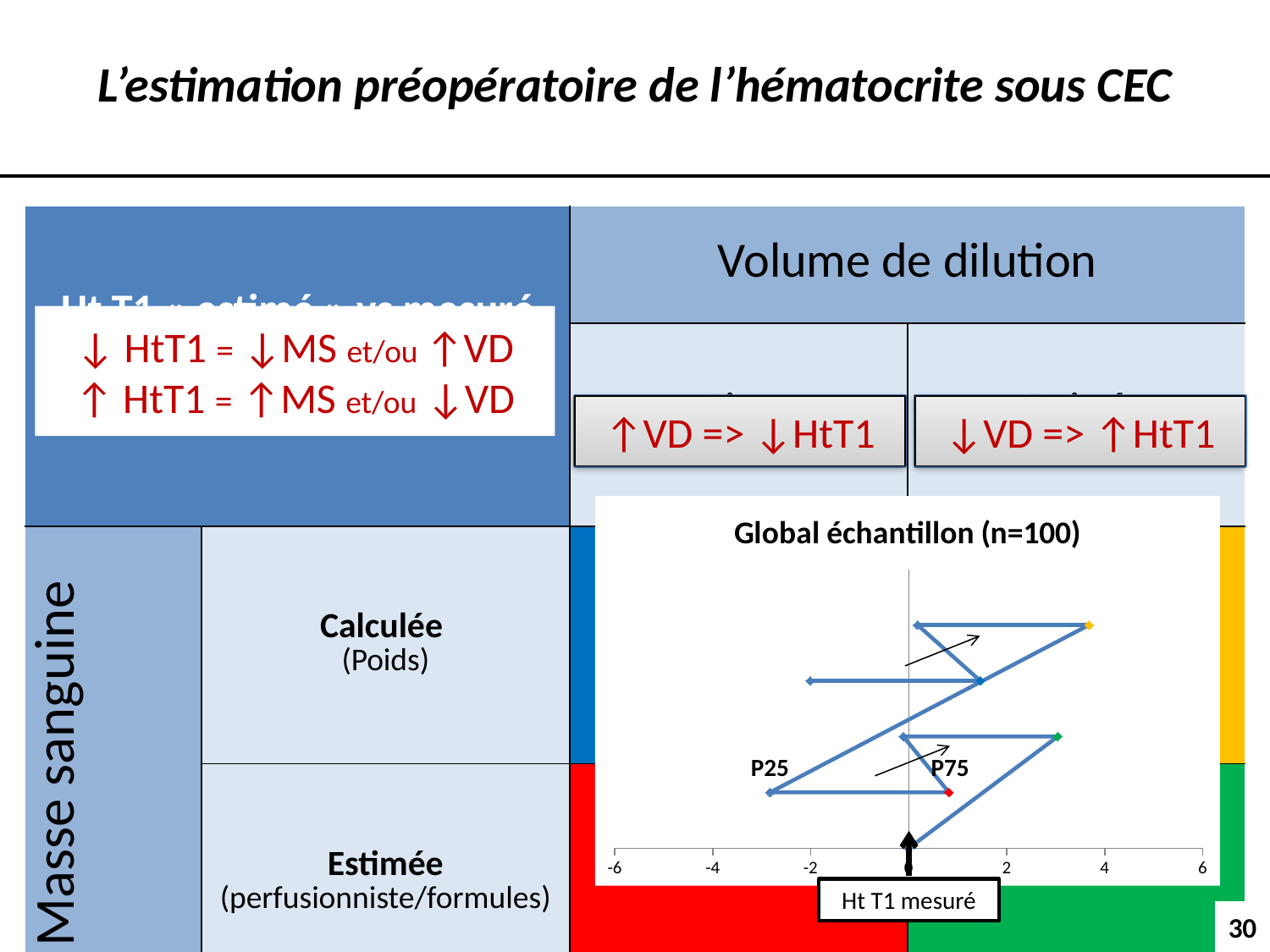
What is the lowest value labelled on the x axis of the chart? -6 What is the sample size stated in the chart title? n=100 What label is attached to the black arrow at the bottom of the chart? Ht T1 mesuré Is the x-axis value of the green marker point (the rightmost point of the lower segment) greater or less than 2? greater What is the highest value labelled on the x axis of the chart? 6 Is the x-axis value of the yellow marker point (the rightmost point of the upper segment) greater or less than 2? greater Is the x-axis value of the point labelled P25 greater or less than -2? less What is the title of the chart on the slide? Global échantillon (n=100) What kind of chart is shown under the title "Global échantillon (n=100)"? line chart Which of the two labelled points, P25 or P75, has the larger x-axis value? P75